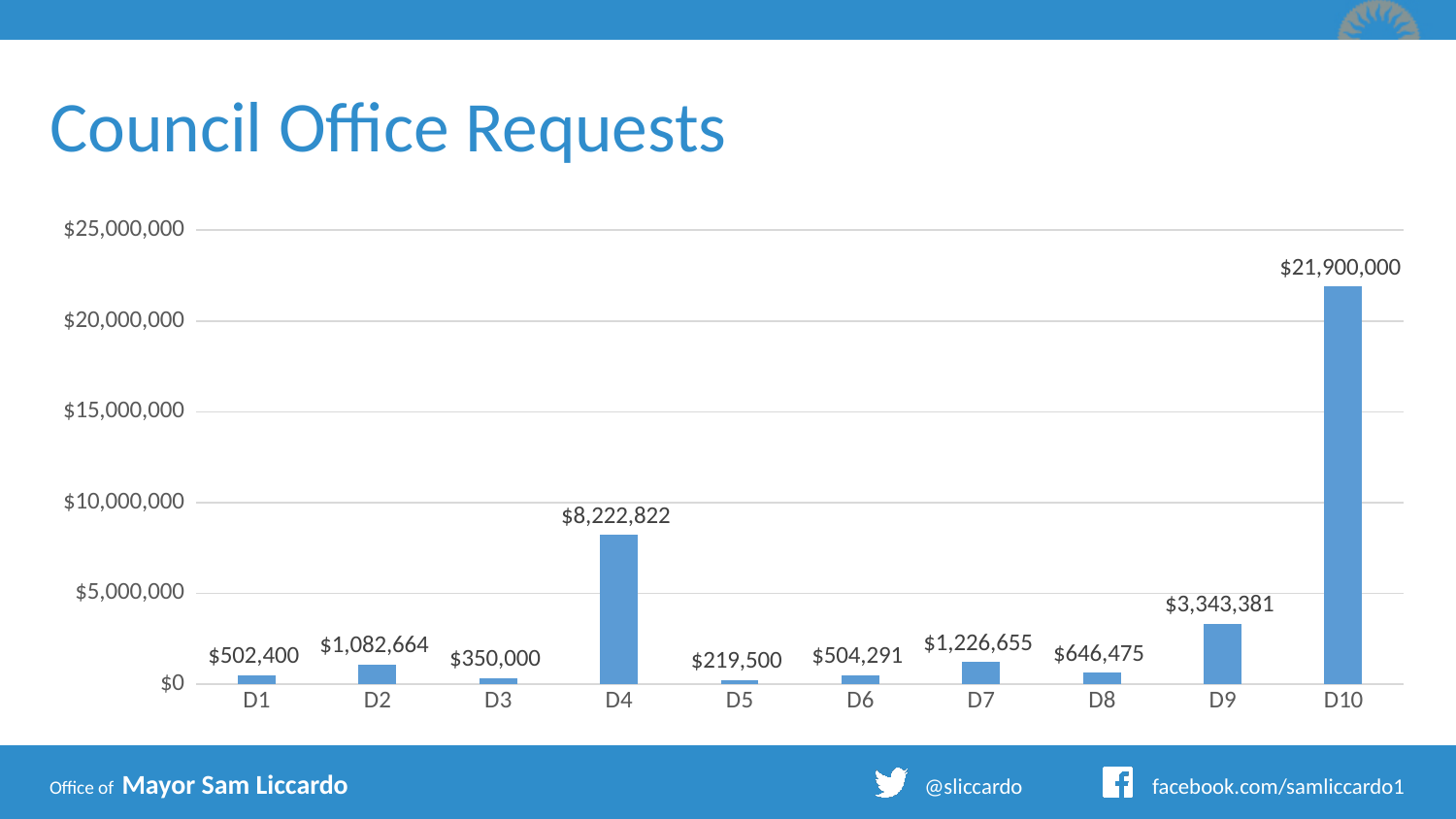
What is the title of the slide? Council Office Requests What is the difference between the values for D10 and D4? $13,677,178 Which district has the lowest request amount? D5 What is the value for D7? $1,226,655 Which district has the highest request amount? D10 What is the value for D9? $3,343,381 How many districts are shown on the x axis? 10 What is the value for D4? $8,222,822 Which is larger, the value for D7 or the value for D8? D7 What kind of chart is shown on the slide? bar chart What is the difference between the values for D9 and D8? $2,696,906 Is the value for D10 greater or less than $20,000,000? greater